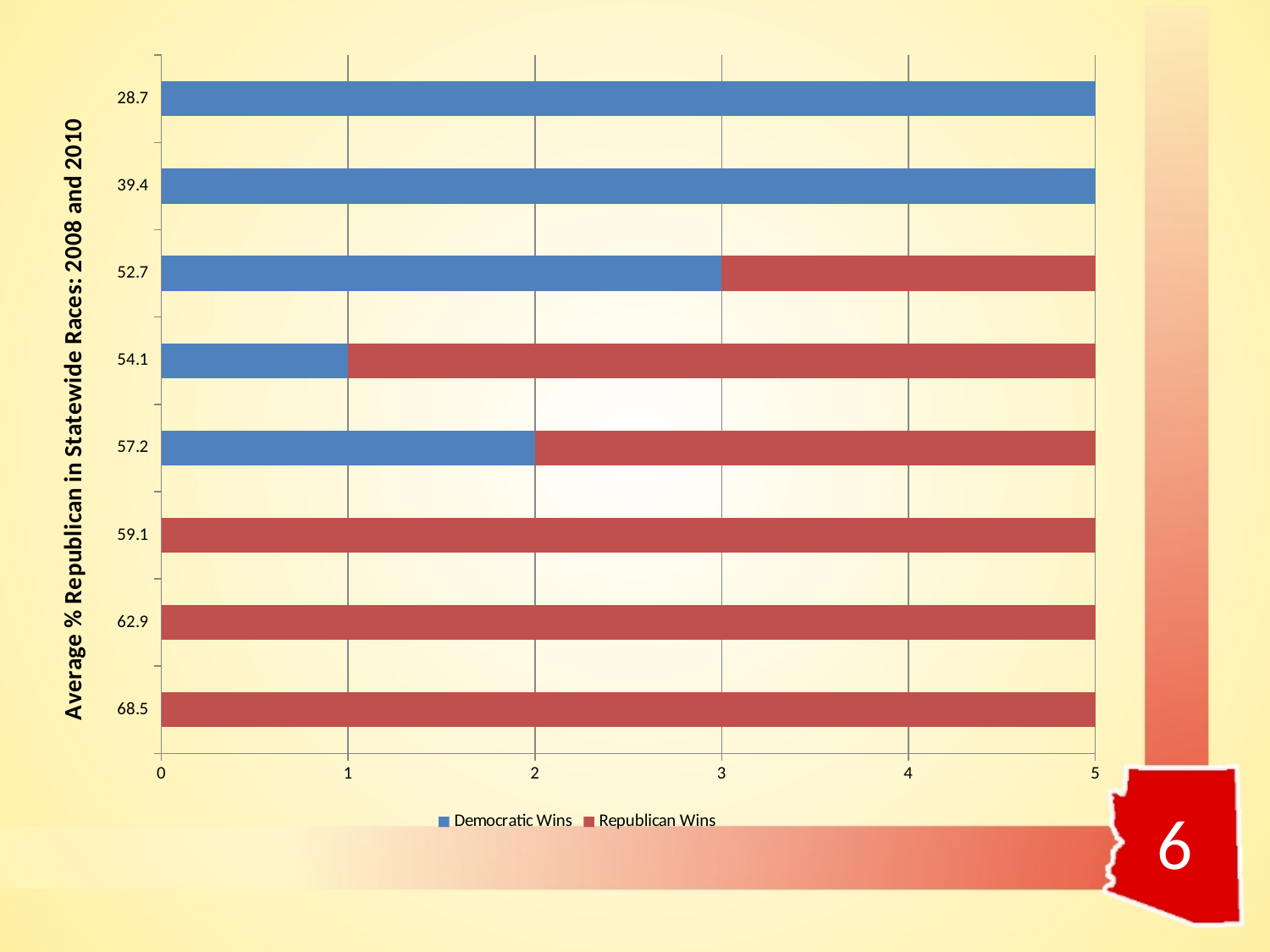
What is the Democratic Wins value for the 28.7 category? 5 How many series does the legend list? 2 What is the Democratic Wins value for the 52.7 category? 3 What is the difference between Republican Wins and Democratic Wins for the 54.1 category? 3 What is the total of the stacked bar for the 54.1 category? 5 How many categories are plotted on the y axis? 8 Which is larger for the 52.7 category, Democratic Wins or Republican Wins? Democratic Wins What is the Democratic Wins value for the 54.1 category? 1 What kind of chart is shown on the slide? Stacked bar chart What is the Republican Wins value for the 57.2 category? 3 What is the title of the y axis? Average % Republican in Statewide Races: 2008 and 2010 What is the Republican Wins value for the 68.5 category? 5